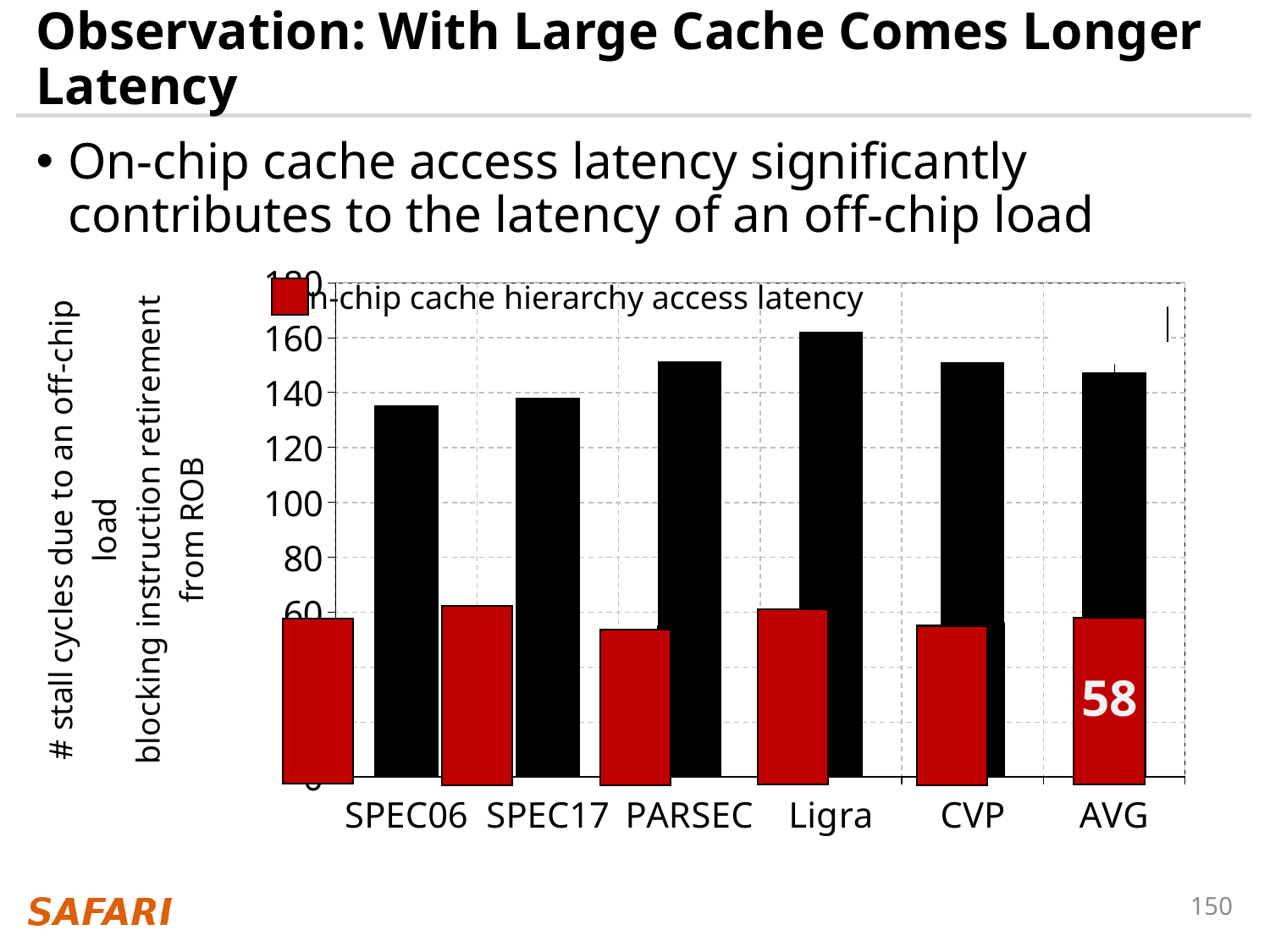
Is the black bar for Ligra greater or less than 140? greater Which has the taller black bar, Ligra or SPEC06? Ligra What kind of chart is shown on the slide? bar chart Is the red bar for PARSEC greater or less than 60? less What is the last category on the x axis of the chart? AVG What value is labelled on the red on-chip cache hierarchy access latency bar for AVG? 58 Which has the taller black bar, PARSEC or SPEC17? PARSEC Which category has the tallest black bar? Ligra How many categories are shown on the x axis of the chart? 6 Is the black bar for PARSEC greater or less than 120? greater What colour are the bars for on-chip cache hierarchy access latency? red